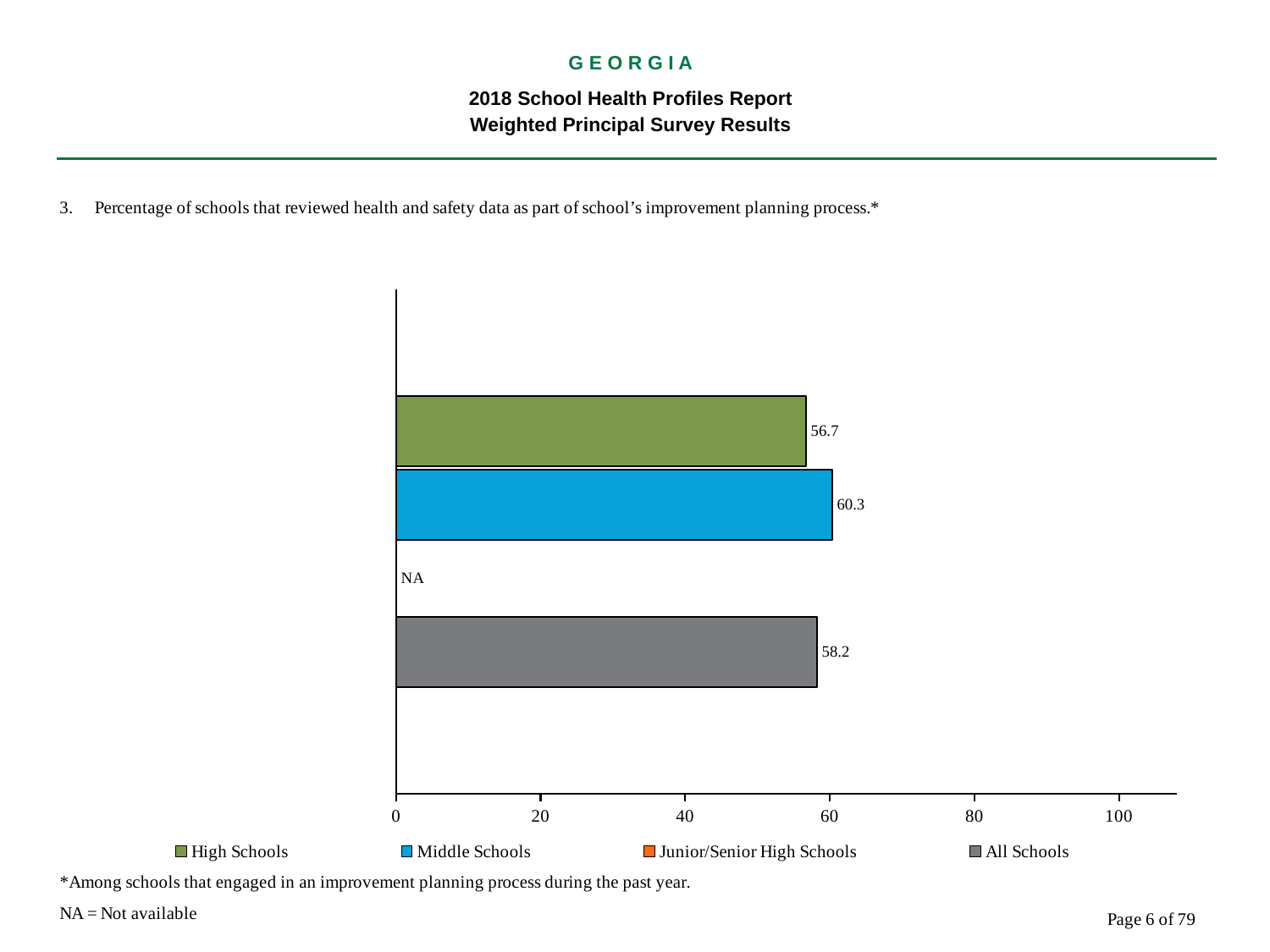
Is the value for High Schools greater or less than 60? less What is the value for All Schools? 58.2 Which school type with a plotted value has the lowest value? High Schools What is the difference between the Middle Schools value and the High Schools value? 3.6 What is the value for Middle Schools? 60.3 What kind of chart is shown on the slide? bar chart What is shown for Junior/Senior High Schools? NA What is the difference between the All Schools value and the High Schools value? 1.5 Which school type has the highest value? Middle Schools What is the value for High Schools? 56.7 How many series does the legend list? 4 Which is larger, the value for Middle Schools or the value for All Schools? Middle Schools